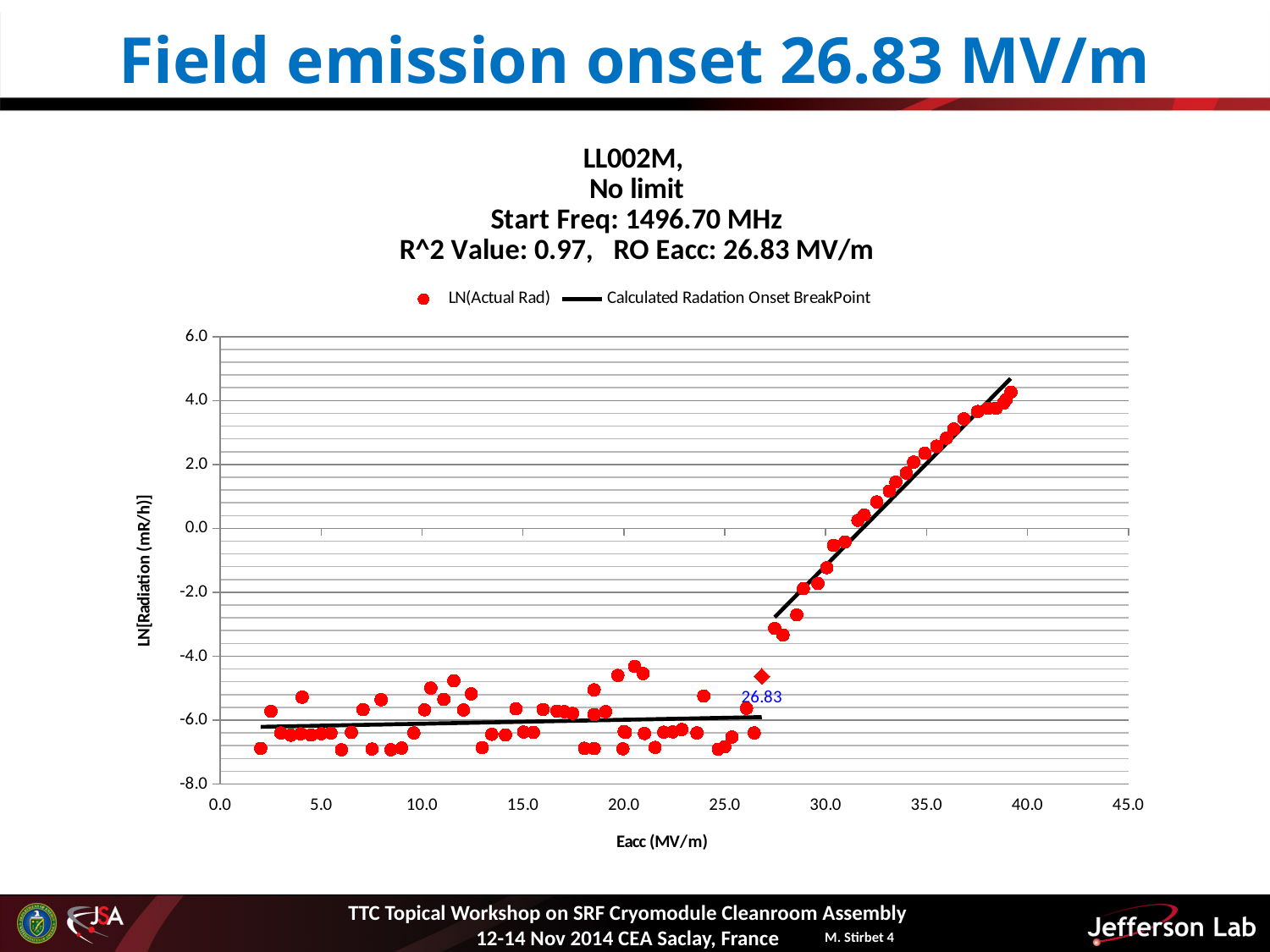
Which has the larger LN(Actual Rad) value: the point near Eacc 38.0 MV/m or the point near Eacc 5.0 MV/m? Eacc 38.0 MV/m Is the LN(Actual Rad) value at Eacc 38.0 MV/m greater or less than 2.0? greater How many series does the chart legend list? 2 Is the LN(Actual Rad) value at Eacc 30.0 MV/m greater or less than 0.0? less Do the LN(Actual Rad) values rise or fall as Eacc increases beyond the 26.83 MV/m breakpoint? rise What Eacc value is printed as the data label at the calculated radiation onset breakpoint? 26.83 What is the title of the x axis of the chart? Eacc (MV/m) What is the title of the y axis of the chart? LN[Radiation (mR/h)] Is the LN(Actual Rad) value at Eacc 10.0 MV/m greater or less than -4.0? less What kind of chart is shown on the slide? scatter chart What is the highest tick value shown on the x axis? 45.0 What is the lowest tick value shown on the y axis? -8.0